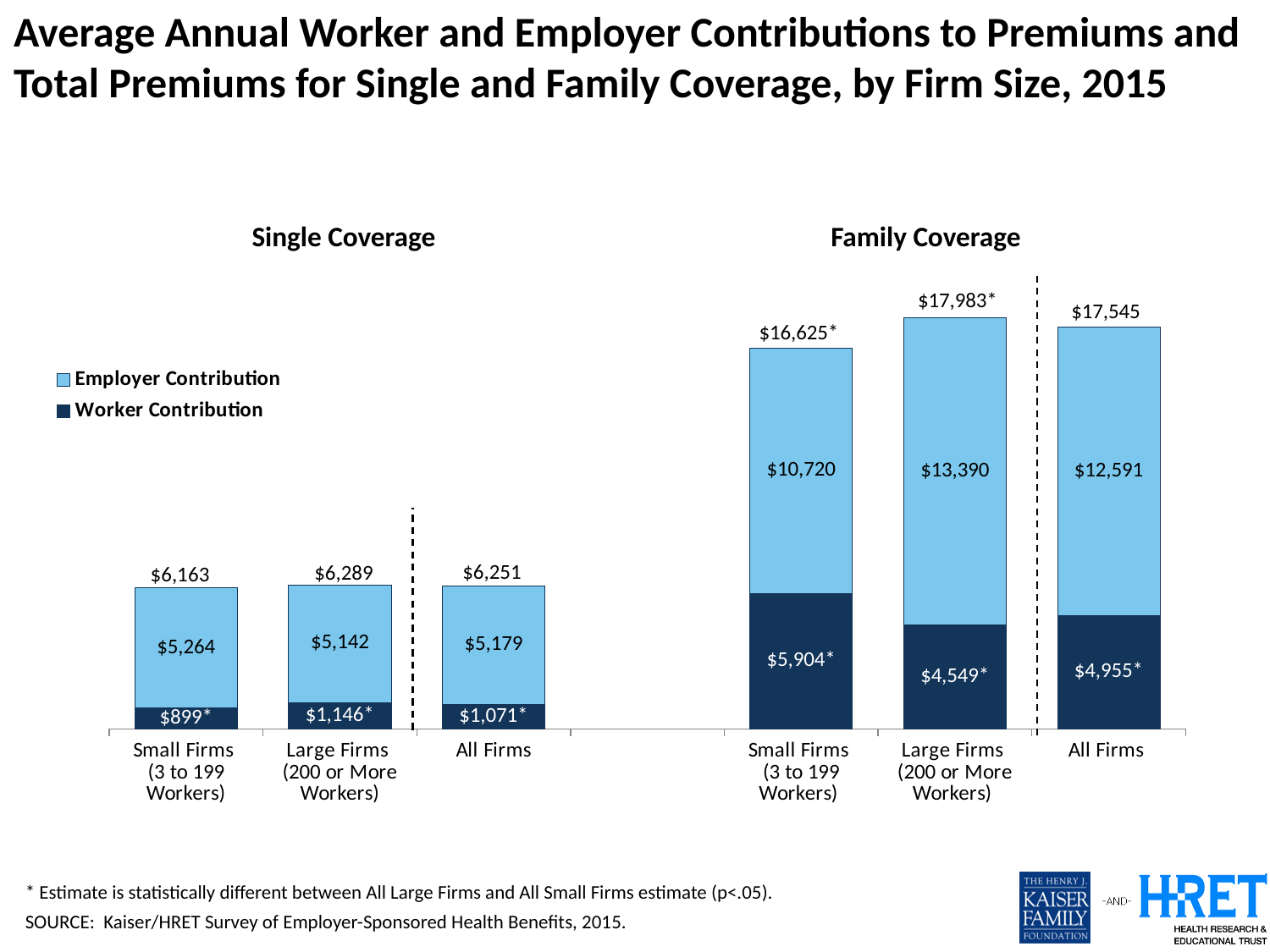
Under Family Coverage, is the Worker Contribution larger for Small Firms or All Firms? Small Firms Which firm-size category has the highest total premium under Family Coverage? Large Firms (200 or More Workers) What is the Employer Contribution for Small Firms (3 to 199 Workers) under Single Coverage? $5,264 What is the total of the stacked bar for Large Firms (200 or More Workers) under Single Coverage? $6,289 What is the total premium shown for All Firms under Family Coverage? $17,545 What is the Worker Contribution for Large Firms (200 or More Workers) under Family Coverage? $4,549 What is the difference between the Employer Contribution for Large Firms and Small Firms under Family Coverage? $2,670 Which firm-size category has the lowest Worker Contribution under Single Coverage? Small Firms (3 to 199 Workers) How many series does the legend list? 2 Which legend entry is shown in the darker blue colour? Worker Contribution Under Single Coverage, is the Worker Contribution larger for Small Firms or Large Firms? Large Firms What kind of chart is shown on the slide? Stacked bar chart